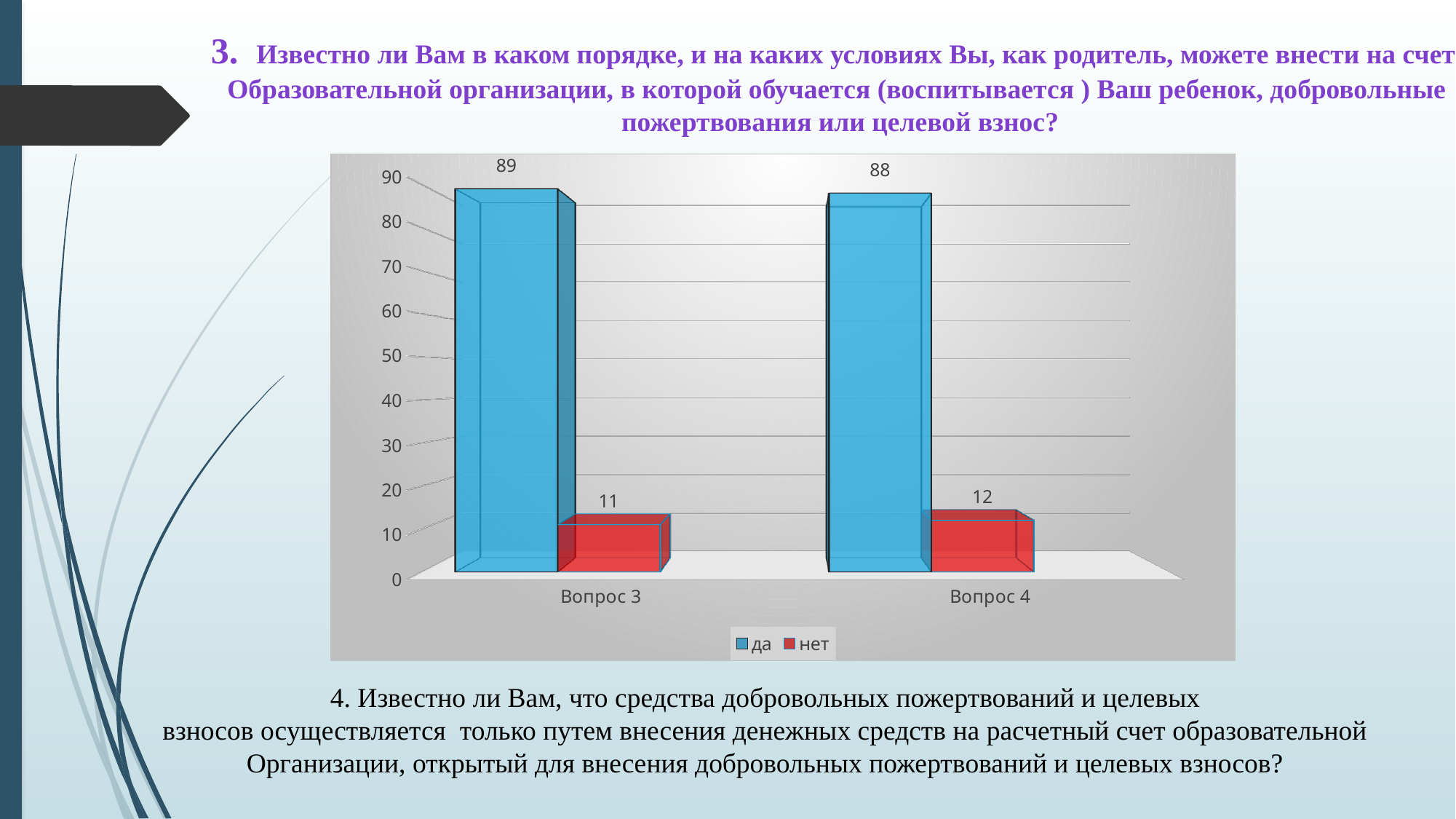
How many series does the legend list? 2 What is the value for "да" for Вопрос 3? 89 What is the value for "нет" for Вопрос 4? 12 Which category has the highest "да" value? Вопрос 3 Which is larger for Вопрос 4: "да" or "нет"? да What kind of chart is shown on the slide? bar chart What is the value for "нет" for Вопрос 3? 11 Which category has the lowest "нет" value? Вопрос 3 How many categories are shown on the x axis? 2 What is the difference between the "нет" values for Вопрос 4 and Вопрос 3? 1 What is the difference between the "да" and "нет" values for Вопрос 3? 78 What is the value for "да" for Вопрос 4? 88